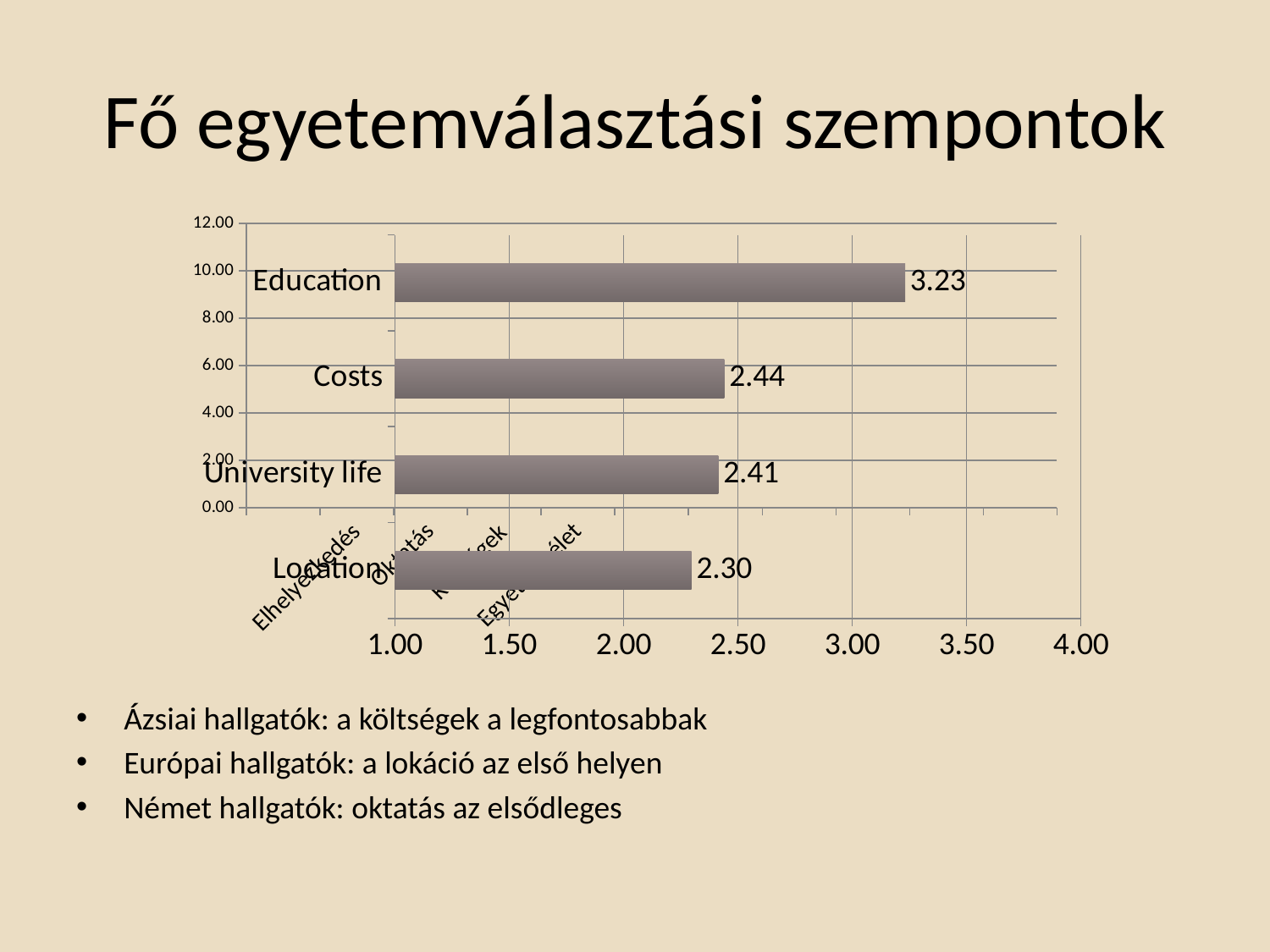
What is the value for Location? 2.30 What is the value for Costs? 2.44 What is the difference between the values for Costs and University life? 0.03 Which category has the lowest value? Location How many categories are shown in the bar chart? 4 What kind of chart is shown on the slide? Bar chart What is the value for Education? 3.23 What is the difference between the values for Education and Location? 0.93 Which category has the highest value? Education Which is larger, the value for Education or the value for Costs? Education What is the value for University life? 2.41 Is the value for Education greater or less than 3.00? greater